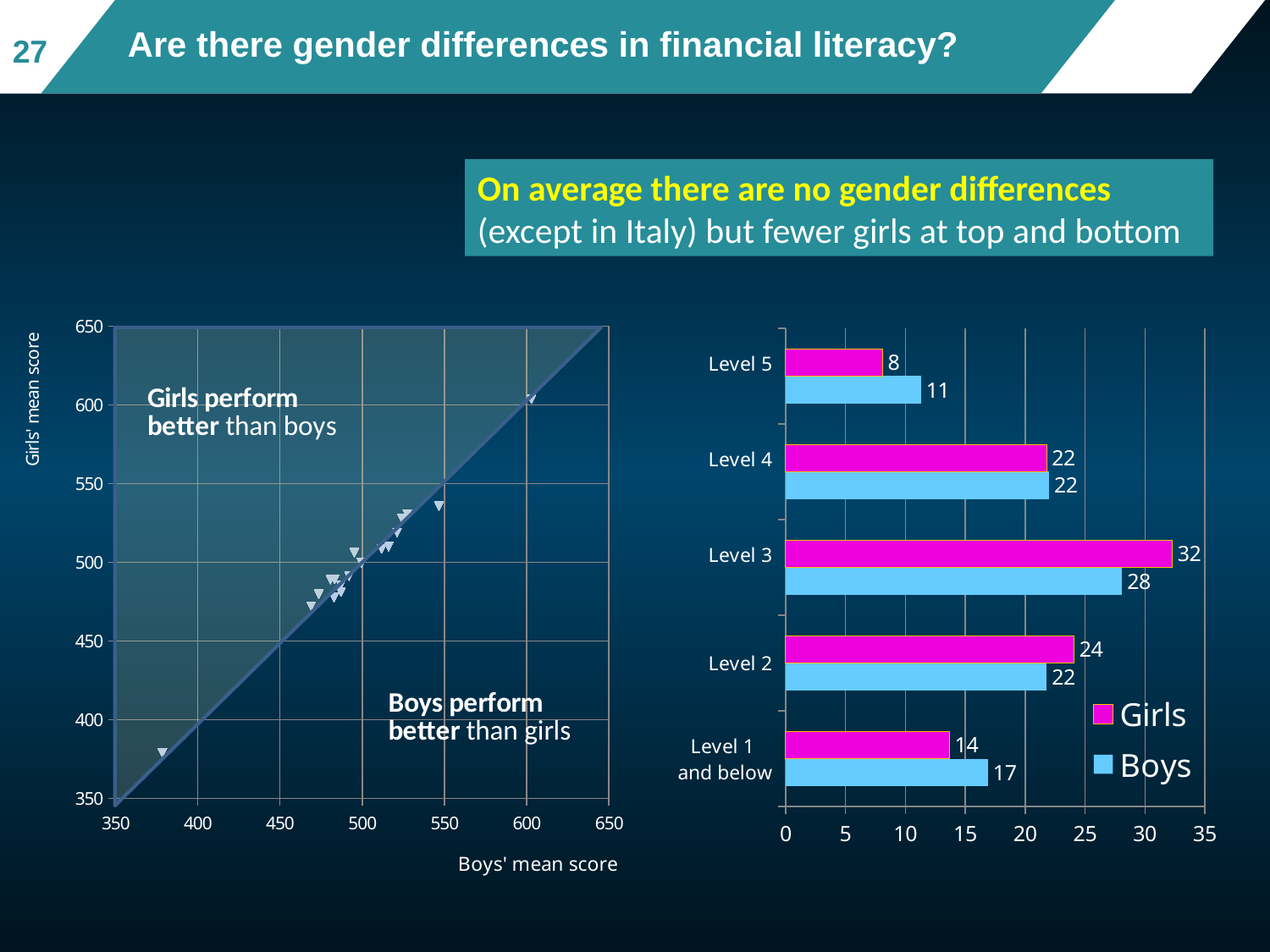
In the bar chart on the right, which level has the highest value for Girls? Level 3 What is the x-axis label of the chart on the left of the slide? Boys' mean score What kind of chart is the chart on the right of the slide? Bar chart In the bar chart on the right, what is the difference between the Girls and Boys values at Level 3? 4 In the bar chart on the right, what is the value for Girls at Level 3? 32 In the bar chart on the right, what is the value for Boys at Level 4? 22 In the bar chart on the right, at Level 5, which series has the larger value, Girls or Boys? Boys In the bar chart on the right, what is the difference between the Boys and Girls values at Level 1 and below? 3 How many series does the legend of the bar chart on the right list? 2 How many levels (categories) are shown in the bar chart on the right? 5 In the bar chart on the right, which level has the lowest value for Girls? Level 5 In the bar chart on the right, what is the value for Boys at Level 1 and below? 17